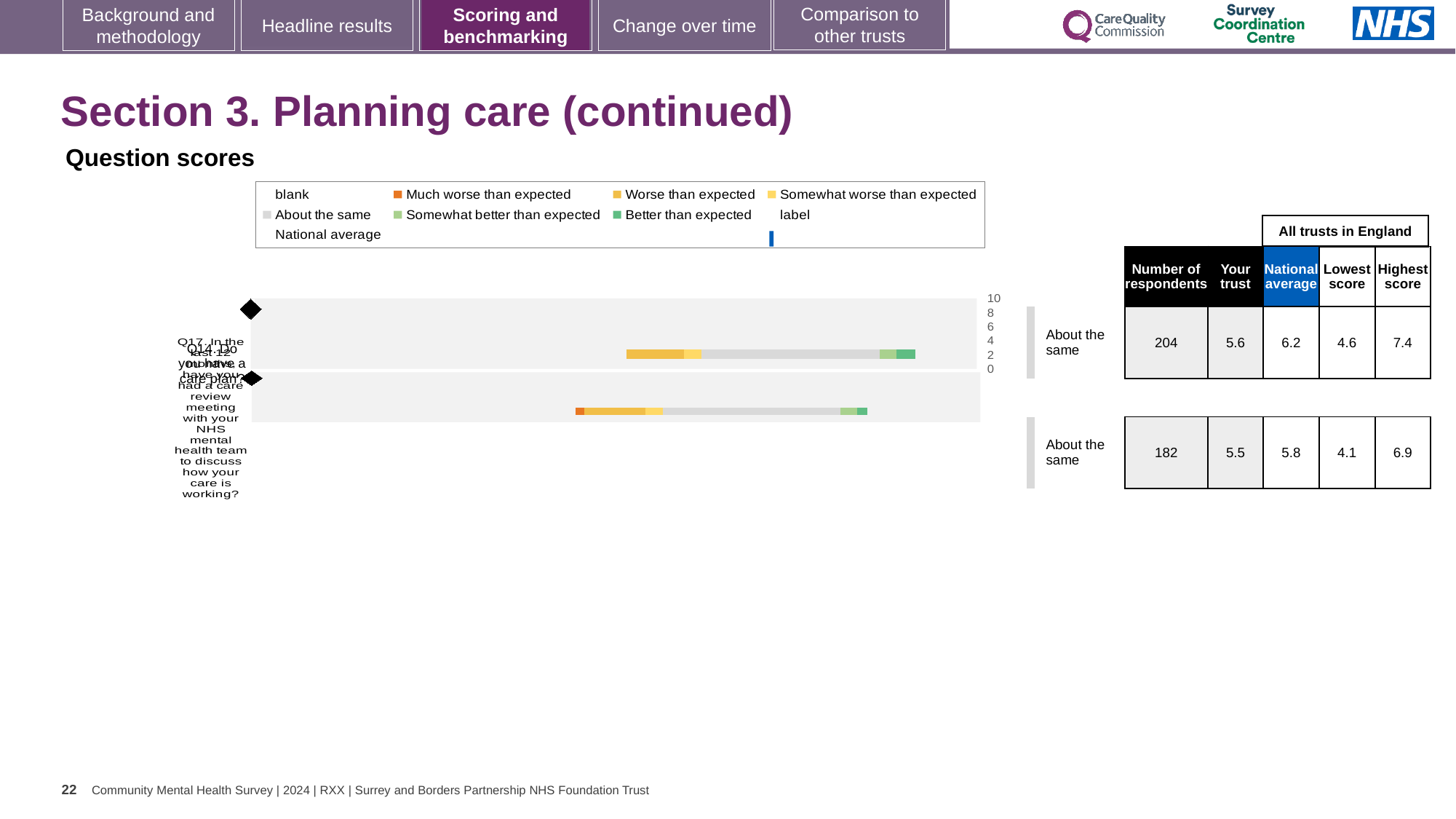
What kind of chart is used to show the question scores? Bar chart How many question rows are plotted in the chart? 2 What is the number of respondents for the top question row in the table? 204 What is the difference between the highest and lowest scores for the bottom question row? 2.8 What benchmark category is shown next to both question rows? About the same What is the highest score across all trusts in England for the top question row? 7.4 What is the number of respondents for the bottom question row in the table? 182 What is the national average for the top question row? 6.2 What is the 'Your trust' score for the top question row? 5.6 What is the lowest score across all trusts in England for the bottom question row? 4.1 Which is larger for the bottom question row: the 'Your trust' score or the national average? National average What is the difference between the national average and the 'Your trust' score for the top question row? 0.6